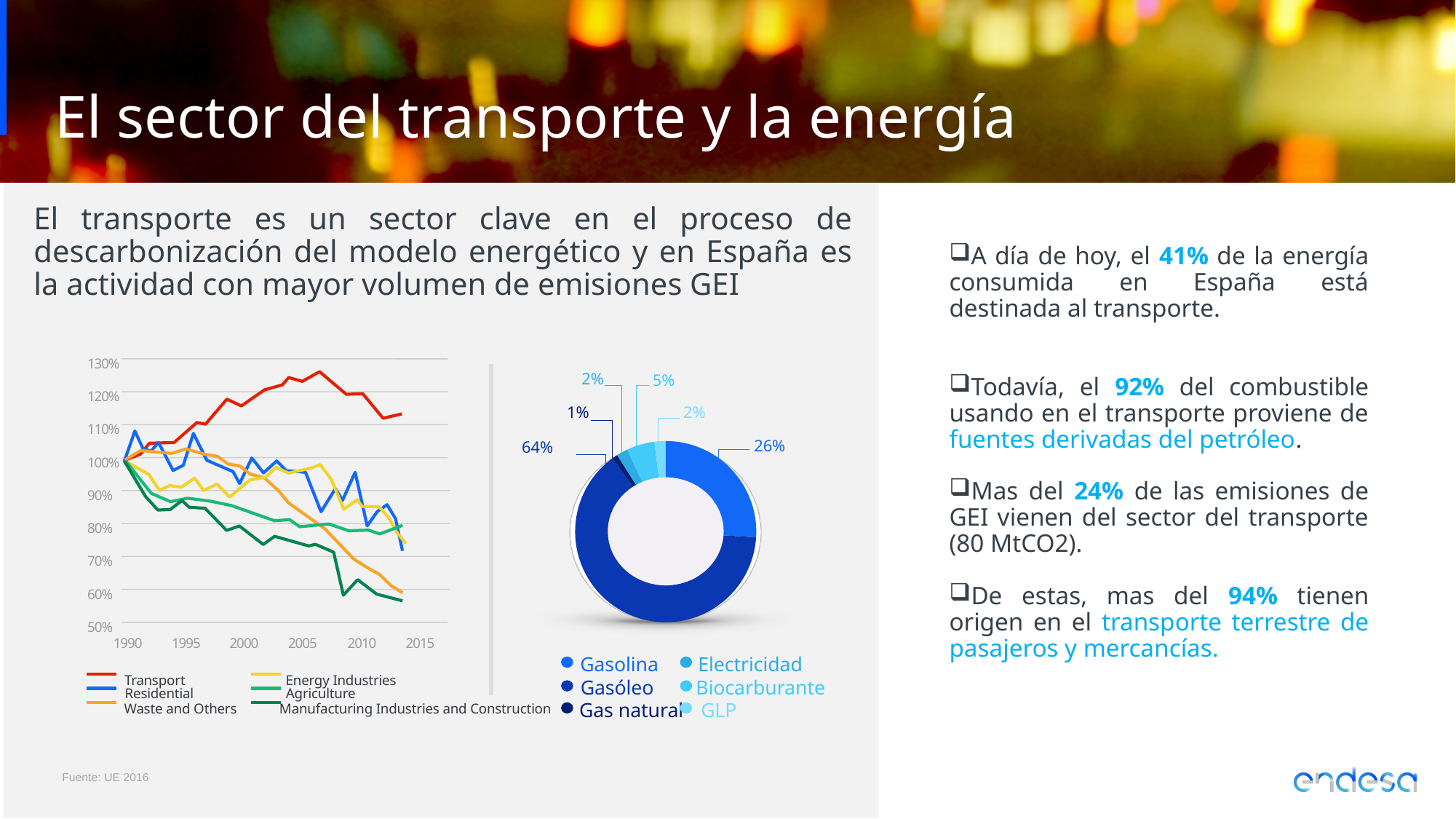
In the line chart on the left, is the peak value of the Transport series greater or less than 120%? greater What kind of chart is the chart on the right of the slide? Doughnut (pie) chart In the line chart on the left, does the Manufacturing Industries and Construction series rise or fall from 1990 to 2015? fall In the doughnut chart on the right, what share does Gasolina have? 26% In the line chart on the left, which series has the highest value at the end of the period (around 2015)? Transport In the doughnut chart on the right, how many fuel categories does the legend list? 6 In the doughnut chart on the right, what share does Gasóleo have? 64% In the doughnut chart on the right, what is the difference between the Gasóleo share and the Gasolina share? 38% In the doughnut chart on the right, what share does Biocarburante have? 5% In the doughnut chart on the right, which fuel has the largest share? Gasóleo In the line chart on the left, how many series does the legend list? 6 What kind of chart is the chart on the left of the slide? Line chart